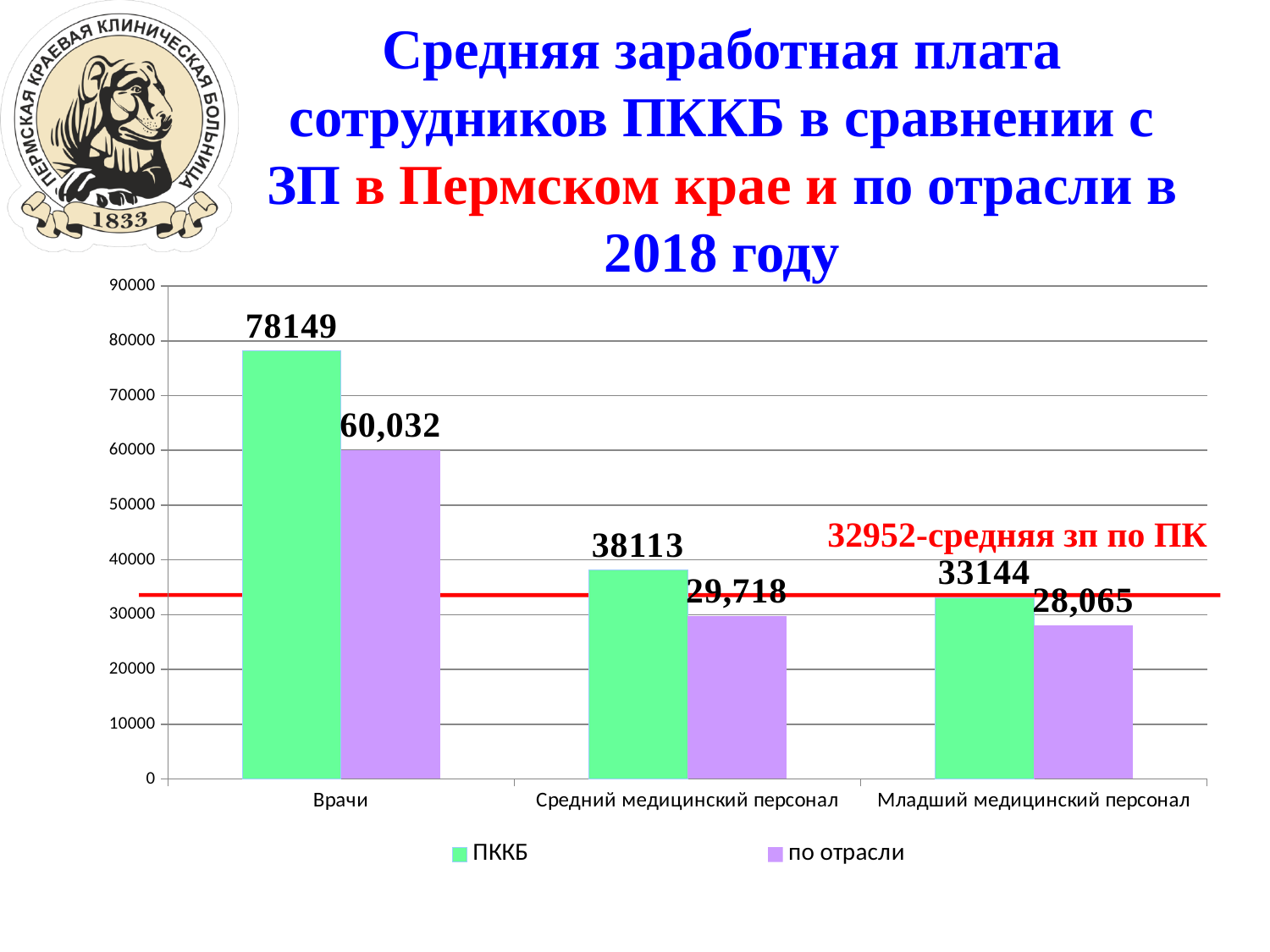
Which category has the lowest по отрасли value? Младший медицинский персонал How many series does the legend list? 2 What is the по отрасли value for Младший медицинский персонал? 28,065 What kind of chart is shown on the slide? bar chart What is the ПККБ value for Средний медицинский персонал? 38113 How many categories are shown on the x axis? 3 Which is larger for Средний медицинский персонал: the ПККБ value or the по отрасли value? ПККБ What is the по отрасли value for Врачи? 60,032 What is the difference between the ПККБ and по отрасли values for Врачи? 18117 What is the ПККБ value for Врачи? 78149 What value does the red horizontal line on the chart represent? 32952 - средняя зп по ПК Which category has the highest ПККБ value? Врачи